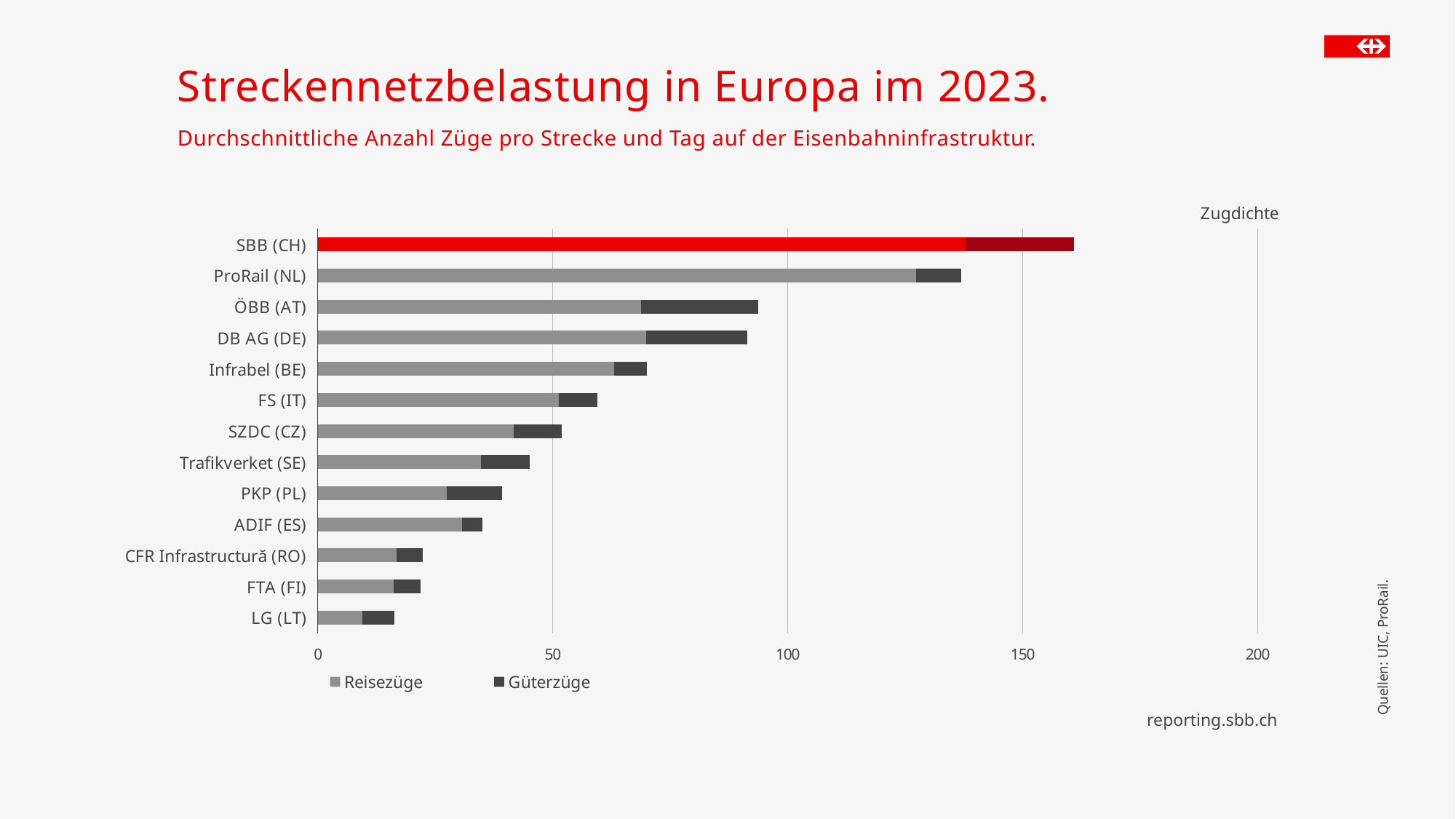
How many series does the legend list? 2 What kind of chart is shown on the slide? Stacked horizontal bar chart What are the two series named in the legend? Reisezüge and Güterzüge Is the total value for Infrabel (BE) greater or less than 50? greater Is the total value for SBB (CH) greater or less than 150? greater Which operator has the highest total train density (Zugdichte)? SBB (CH) Is the total value for ProRail (NL) greater or less than 150? less What is the title of the chart on the slide? Streckennetzbelastung in Europa im 2023. Which operator has the lowest total train density? LG (LT) How many railway infrastructure operators are listed on the chart? 13 Which has a larger total train density, Infrabel (BE) or FS (IT)? Infrabel (BE)